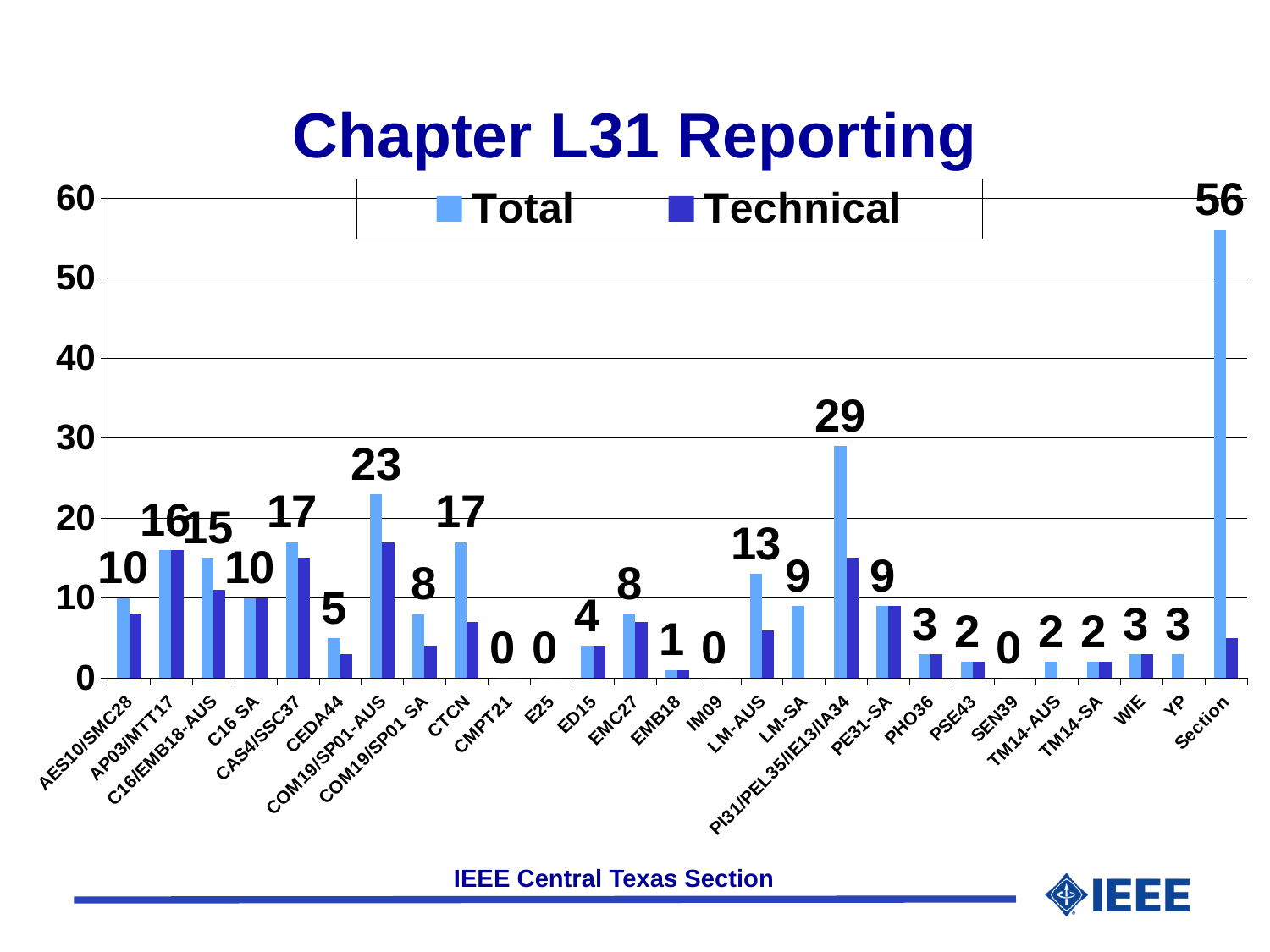
What is the Total value for LM-AUS? 13 Which has a larger Total value, CAS4/SSC37 or CEDA44? CAS4/SSC37 What is the title of the chart? Chapter L31 Reporting How many series does the legend list? 2 Is the Technical value for COM19/SP01-AUS greater or less than 10? greater Which category has the highest Total value? Section What kind of chart is shown on the slide? bar chart What is the Total value for COM19/SP01-AUS? 23 What is the difference between the Total values for Section and PI31/PEL35/IE13/IA34? 27 How many categories are shown on the x axis? 27 What is the Total value for PI31/PEL35/IE13/IA34? 29 Is the Technical value for Section greater or less than 10? less